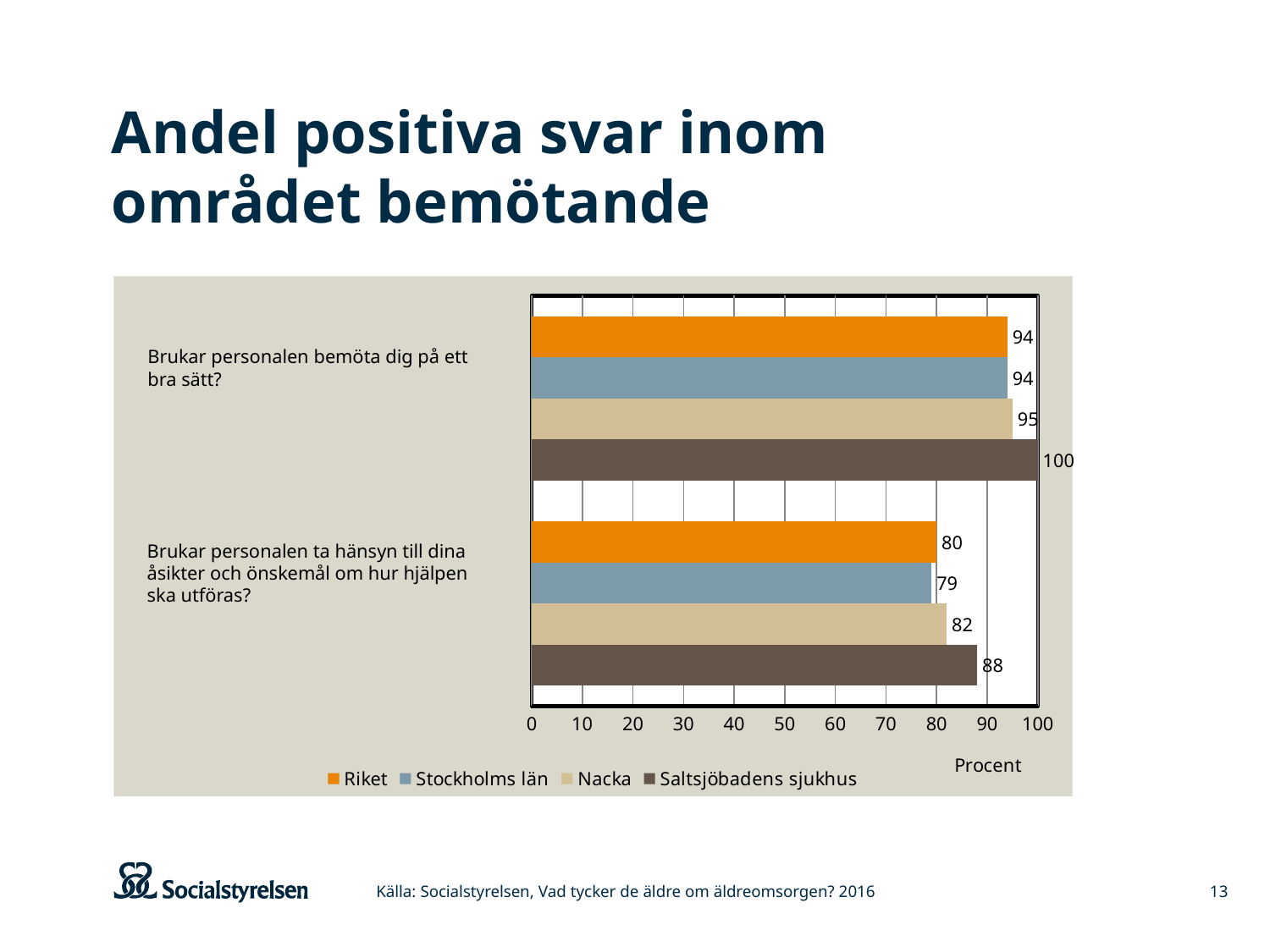
Which series has the highest value on the question "Brukar personalen ta hänsyn till dina åsikter och önskemål om hur hjälpen ska utföras?"? Saltsjöbadens sjukhus How many series does the legend list? 4 Which is larger for Nacka: the value on "Brukar personalen bemöta dig på ett bra sätt?" or on "Brukar personalen ta hänsyn till dina åsikter och önskemål om hur hjälpen ska utföras?"? Brukar personalen bemöta dig på ett bra sätt? What is the value for Saltsjöbadens sjukhus on the question "Brukar personalen bemöta dig på ett bra sätt?"? 100 What is the label of the horizontal axis? Procent Which series has the lowest value on the question "Brukar personalen ta hänsyn till dina åsikter och önskemål om hur hjälpen ska utföras?"? Stockholms län What is the difference between the Saltsjöbadens sjukhus value and the Nacka value on the question "Brukar personalen ta hänsyn till dina åsikter och önskemål om hur hjälpen ska utföras?"? 6 What is the value for Nacka on the question "Brukar personalen bemöta dig på ett bra sätt?"? 95 What is the value for Stockholms län on the question "Brukar personalen ta hänsyn till dina åsikter och önskemål om hur hjälpen ska utföras?"? 79 What kind of chart is shown on the slide? Bar chart How many questions (categories) are shown on the chart? 2 What is the value for Riket on the question "Brukar personalen ta hänsyn till dina åsikter och önskemål om hur hjälpen ska utföras?"? 80